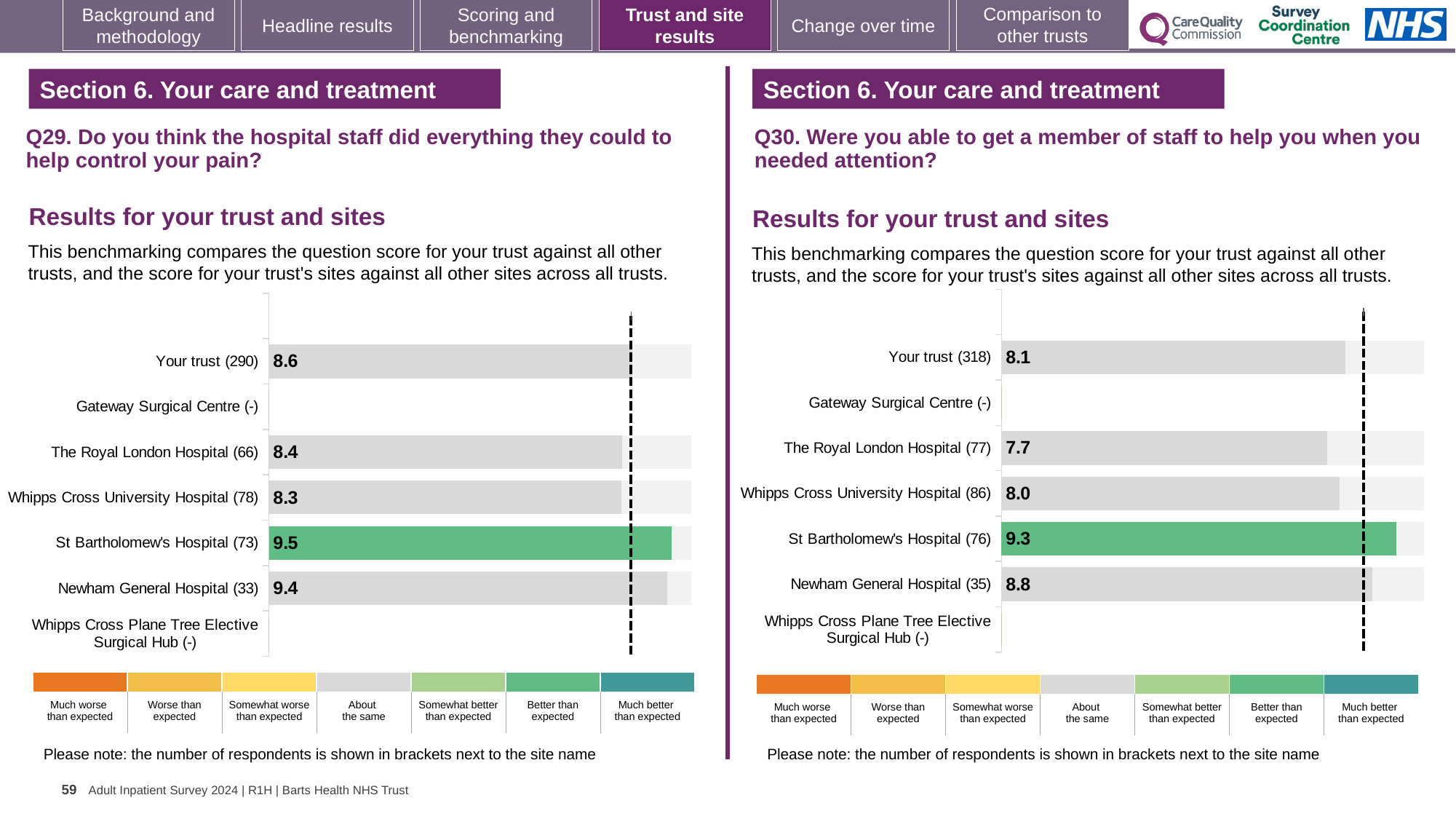
In the Q30 chart on the right, what is the difference between the scores for St Bartholomew's Hospital and Your trust? 1.2 How many site or trust labels are listed on the Q29 chart on the left? 7 What type of chart is used for the Q30 results on the right? Bar chart In the Q30 chart on the right, which site has the highest score? St Bartholomew's Hospital In the Q29 chart on the left, which site has the highest score? St Bartholomew's Hospital In the Q29 chart on the left, how many respondents are shown for Newham General Hospital? 33 In the Q30 chart on the right, what is the score for The Royal London Hospital? 7.7 In the Q30 chart on the right, which site with a plotted score has the lowest score? The Royal London Hospital In the Q30 chart on the right, which is larger: the score for Newham General Hospital or the score for Whipps Cross University Hospital? Newham General Hospital In the Q29 chart on the left, what is the score for Your trust? 8.6 In the Q29 chart on the left, which site with a plotted score has the lowest score? Whipps Cross University Hospital In the Q29 chart on the left, what is the difference between the scores for St Bartholomew's Hospital and The Royal London Hospital? 1.1